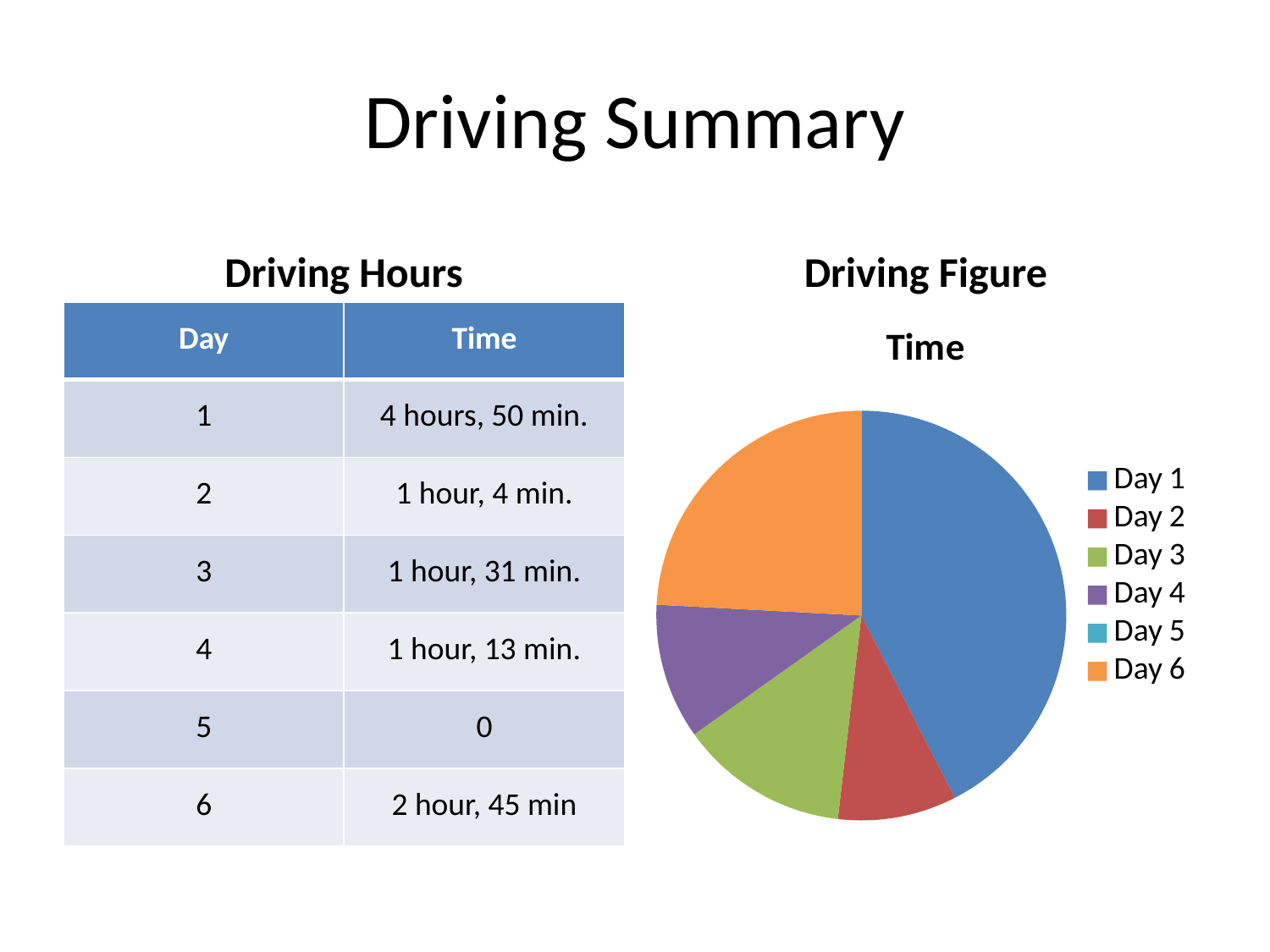
According to the Driving Hours table on the slide, what is the time for Day 6? 2 hour, 45 min What colour is the Day 1 slice in the pie chart? blue In the pie chart, which slice is larger, Day 1 or Day 6? Day 1 In the pie chart, which slice is larger, Day 6 or Day 3? Day 6 How many slices are visible in the pie chart? 5 In the pie chart, which slice is larger, Day 3 or Day 2? Day 3 Which legend entry of the pie chart has no visible slice? Day 5 What is the title of the pie chart? Time Which day has the largest slice in the pie chart? Day 1 According to the Driving Hours table on the slide, what is the time for Day 1? 4 hours, 50 min. What kind of chart is shown under the heading "Driving Figure"? pie chart How many entries does the pie chart's legend list? 6